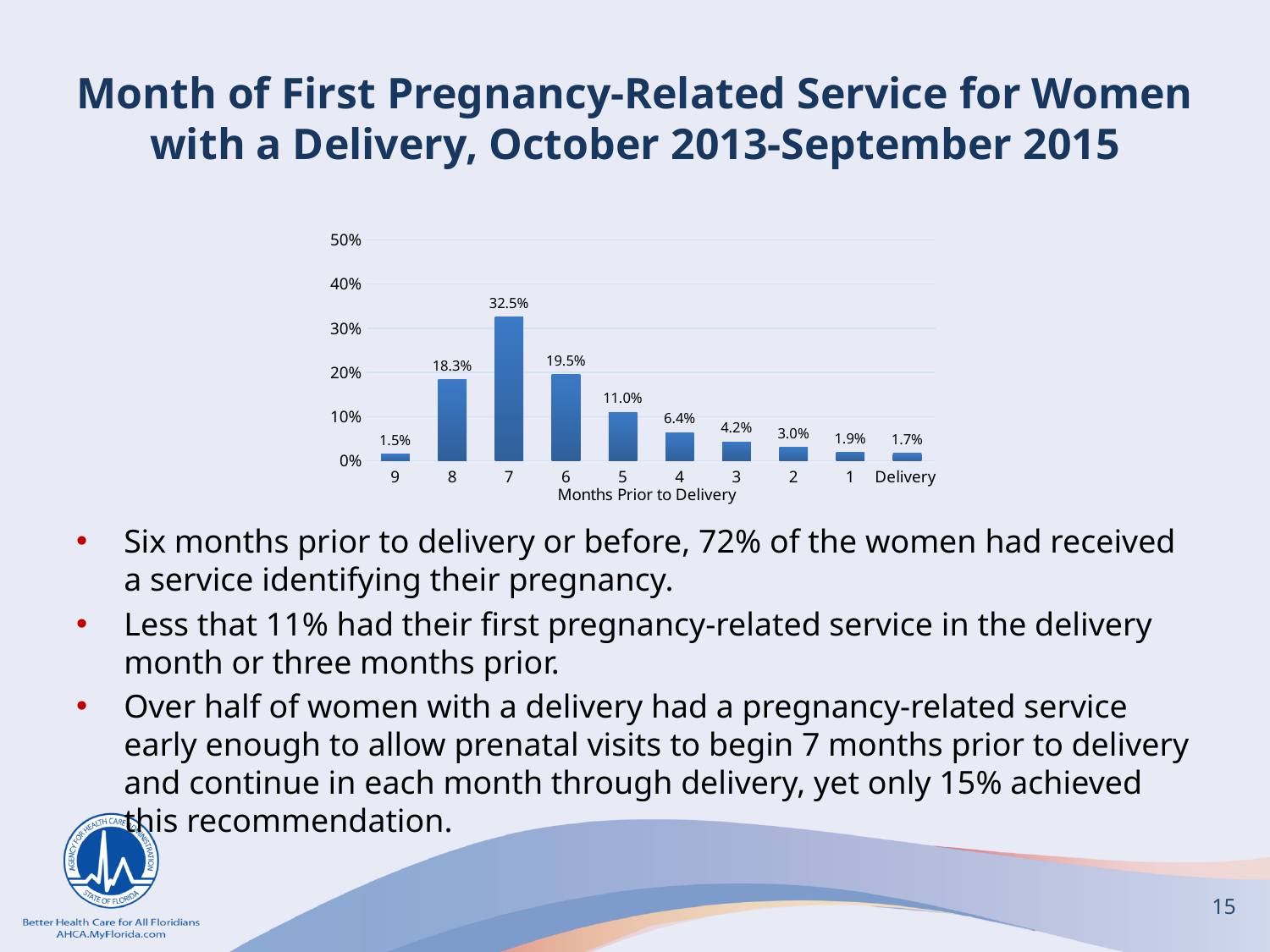
From 7 months prior to delivery through the Delivery month, do the values rise or fall? Fall Which is larger, the value for 8 months prior or the value for 6 months prior to delivery? 6 months prior (19.5%) How many categories are shown on the x axis? 10 What is the value for 9 months prior to delivery? 1.5% What percentage of women had their first pregnancy-related service 7 months prior to delivery? 32.5% Is the value for 5 months prior to delivery greater or less than 10%? greater What is the value shown for the Delivery month? 1.7% Which month prior to delivery has the highest percentage? 7 What is the difference between the values for 7 months and 6 months prior to delivery? 13.0% What kind of chart is shown on the slide? Bar chart Which category has the lowest percentage? 9 What is the label of the x axis? Months Prior to Delivery